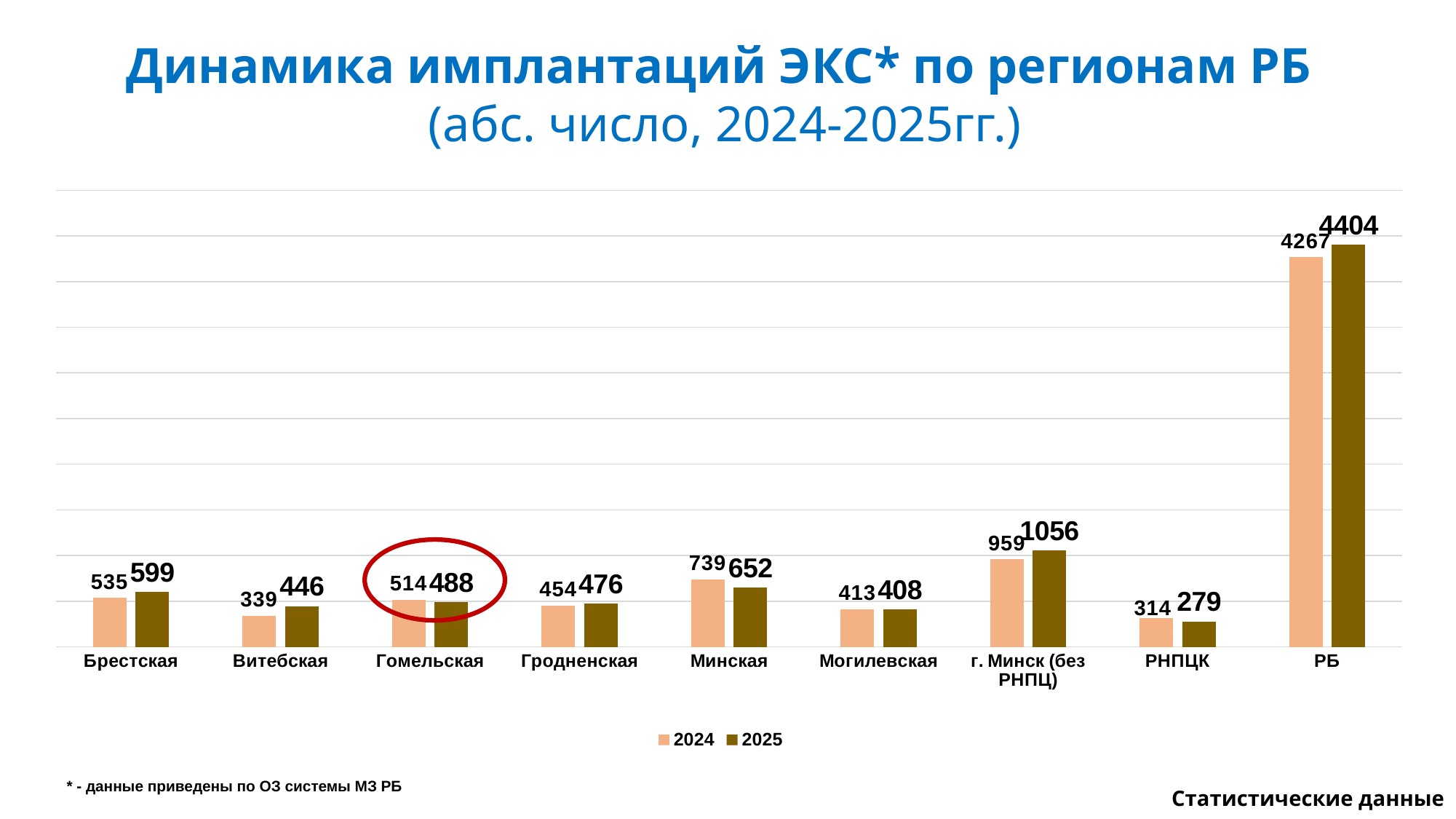
What kind of chart is shown on the slide? bar chart What is the difference between the 2025 and 2024 values for РБ? 137 What is the difference between the 2024 and 2025 values for Минская? 87 What is the 2025 value for г. Минск (без РНПЦ)? 1056 Which category has the highest 2025 value? РБ What is the 2025 value for Брестская? 599 Excluding РБ, which category has the lowest 2025 value? РНПЦК Which category is circled in red on the chart? Гомельская How many series does the legend list? 2 For Гомельская, which is larger: the 2024 value or the 2025 value? 2024 What is the 2024 value for Витебская? 339 How many categories are shown on the x axis? 9